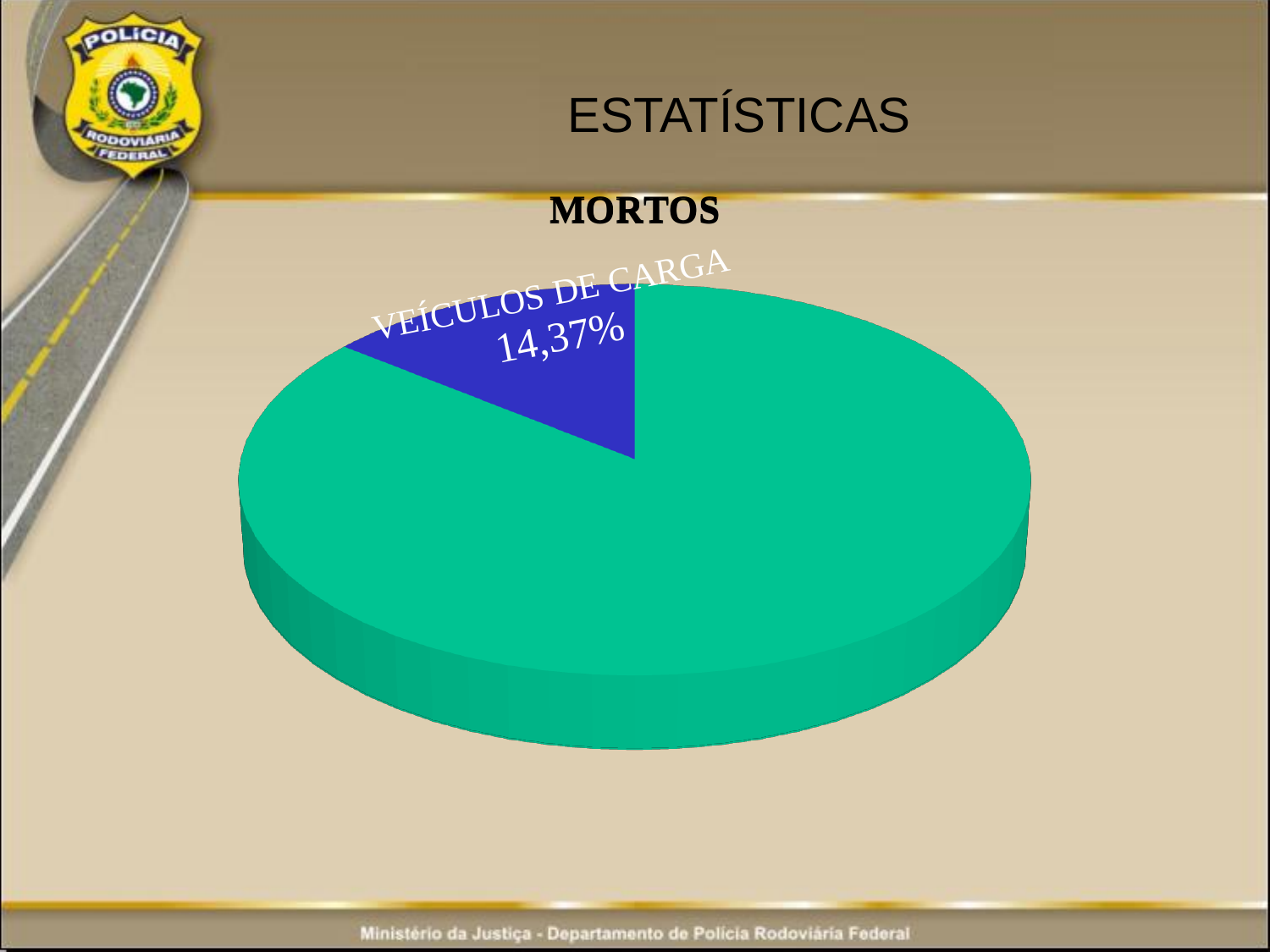
What share of the pie does VEÍCULOS DE CARGA represent? 14,37% What percentage is shown for the VEÍCULOS DE CARGA slice? 14,37% What kind of chart is shown on the slide? pie chart What colour is the VEÍCULOS DE CARGA slice? blue Which slice is the smallest in the pie chart? VEÍCULOS DE CARGA What is the title of the chart? MORTOS Which slice is larger: the VEÍCULOS DE CARGA slice or the unlabeled green slice? the unlabeled green slice Is the VEÍCULOS DE CARGA slice greater or less than 50% of the pie? less How many slices does the pie chart have? 2